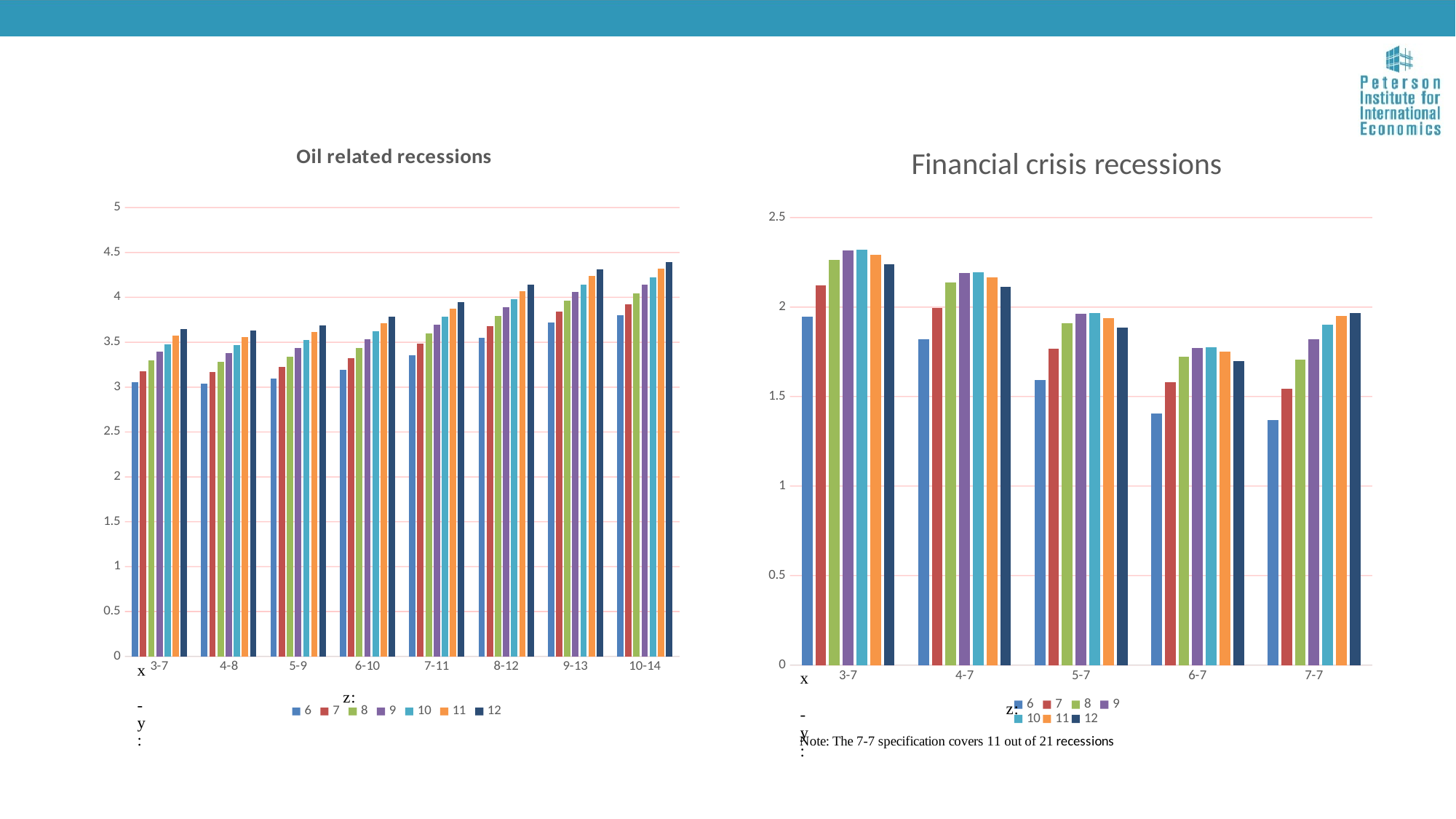
In the 'Oil related recessions' chart, which category has the tallest bar for series 12? 10-14 What type of chart is the 'Oil related recessions' chart? bar chart How many series does the legend of the 'Financial crisis recessions' chart list? 7 In the 'Oil related recessions' chart, do the values for series 12 rise or fall from 3-7 to 10-14? rise How many categories are shown on the x axis of the 'Oil related recessions' chart? 8 In the 'Financial crisis recessions' chart, which is larger for series 6: the value at 3-7 or the value at 4-7? 3-7 How many categories are shown on the x axis of the 'Financial crisis recessions' chart? 5 In the 'Oil related recessions' chart, is the value for series 6 at 7-11 greater or less than 3.5? less How many series does the legend of the 'Oil related recessions' chart list? 7 In the 'Financial crisis recessions' chart, is the value for series 12 at 3-7 greater or less than 2? greater In the 'Financial crisis recessions' chart, is the value for series 6 at 6-7 greater or less than 1.5? less